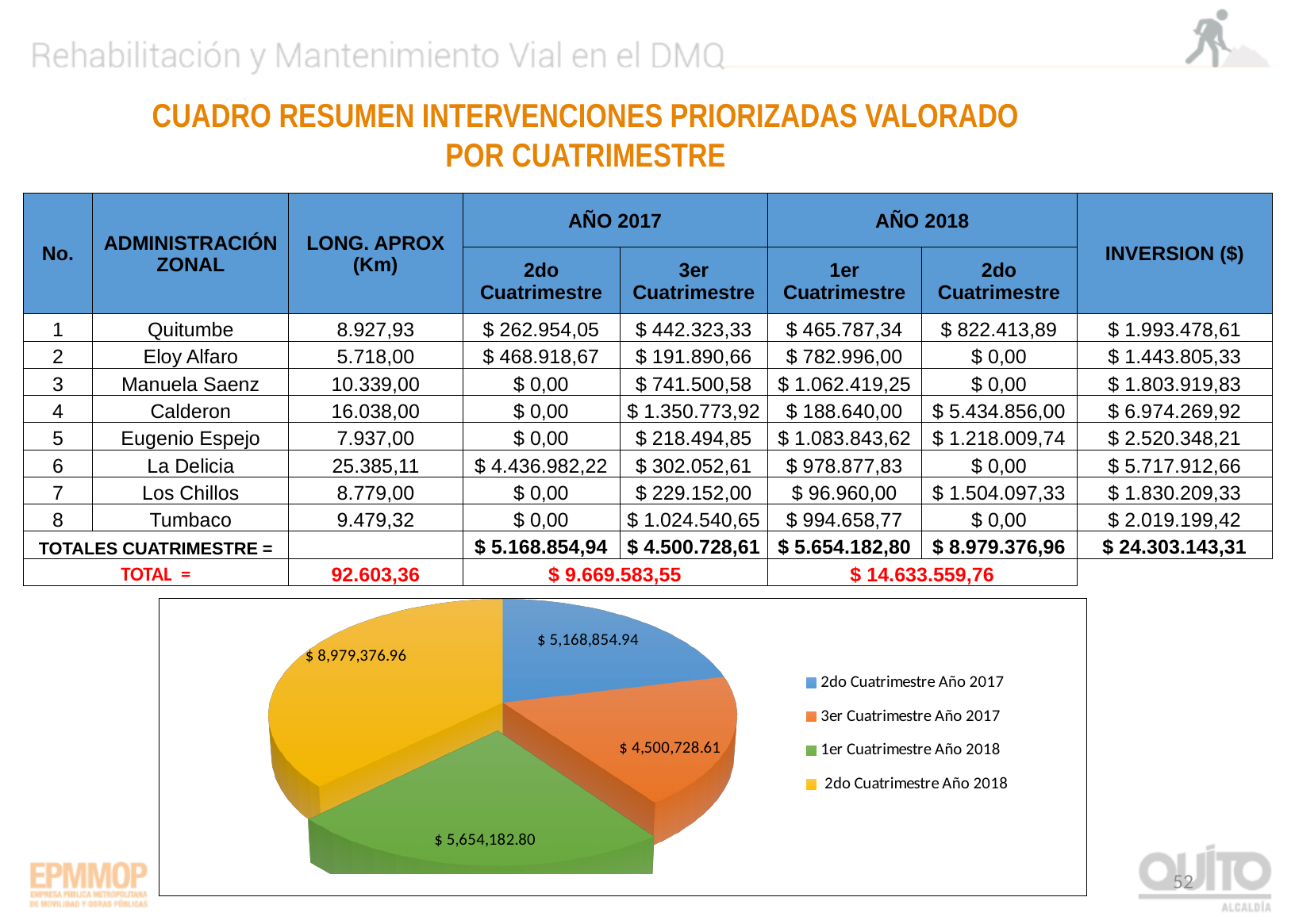
In the pie chart, what is the value for 3er Cuatrimestre Año 2017? $ 4,500,728.61 What colour is the 2do Cuatrimestre Año 2018 slice in the pie chart? Yellow How many slices does the pie chart have? 4 In the pie chart, which is larger: 1er Cuatrimestre Año 2018 or 2do Cuatrimestre Año 2017? 1er Cuatrimestre Año 2018 In the pie chart, what is the difference between the 2do Cuatrimestre Año 2018 value and the 1er Cuatrimestre Año 2018 value? $ 3,325,194.16 Which slice of the pie chart has the largest value? 2do Cuatrimestre Año 2018 In the pie chart, what is the value for 2do Cuatrimestre Año 2018? $ 8,979,376.96 In the pie chart, what is the value for 2do Cuatrimestre Año 2017? $ 5,168,854.94 What kind of chart is shown at the bottom of the slide? Pie chart Which slice of the pie chart has the smallest value? 3er Cuatrimestre Año 2017 How many entries does the pie chart's legend list? 4 In the pie chart, what is the value for 1er Cuatrimestre Año 2018? $ 5,654,182.80